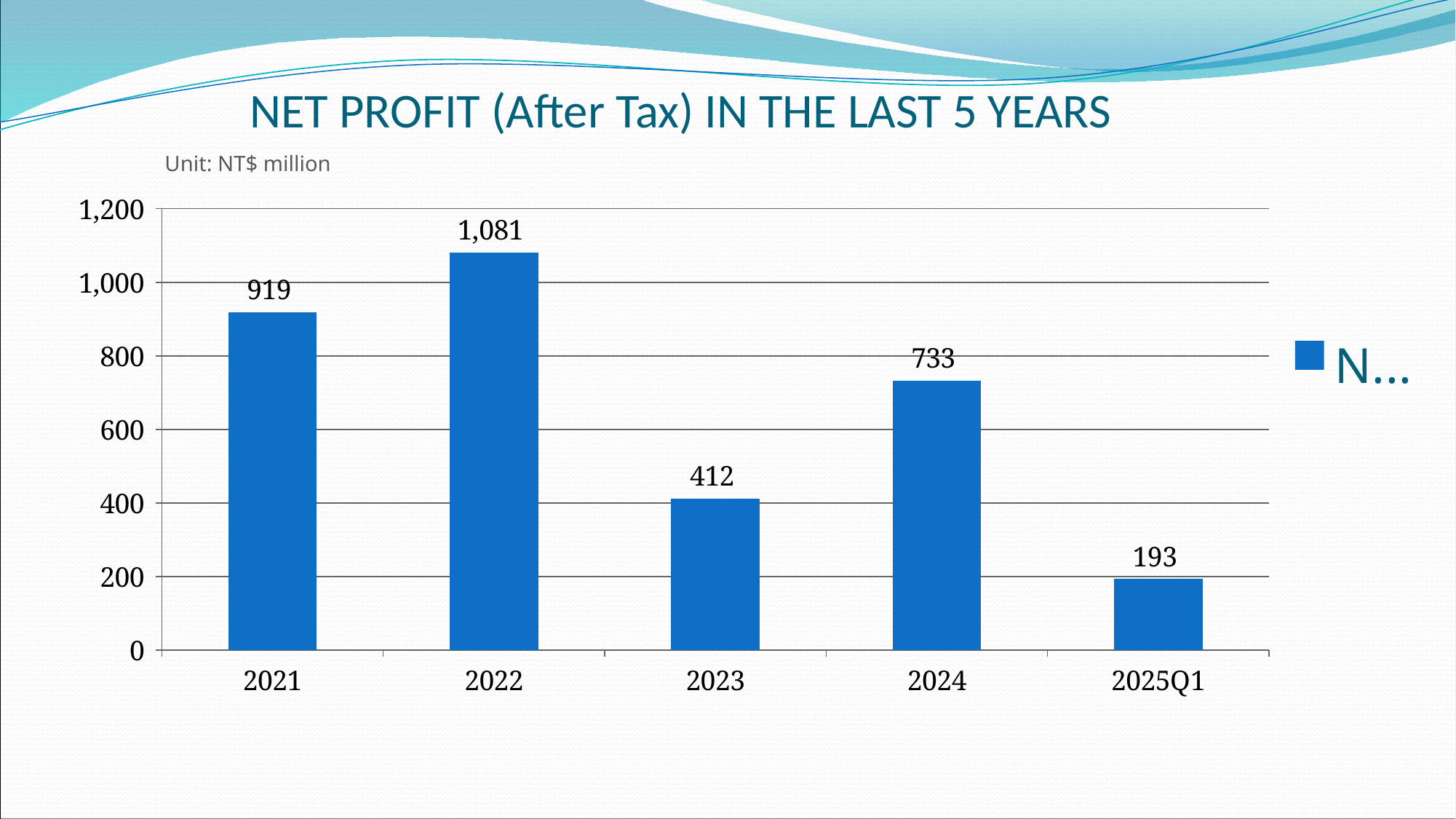
What is the net profit value for 2023? 412 What is the difference between the net profit in 2022 and 2023? 669 What is the net profit value for 2022? 1,081 How many periods are shown on the x axis? 5 What is the net profit value for 2021? 919 What kind of chart is shown on the slide? Bar chart What is the net profit value for 2025Q1? 193 Which period has the highest net profit? 2022 Which period has the lowest net profit? 2025Q1 Which is larger, the net profit in 2021 or in 2024? 2021 What is the difference between the net profit in 2024 and 2025Q1? 540 What unit is stated for the values in the chart? NT$ million